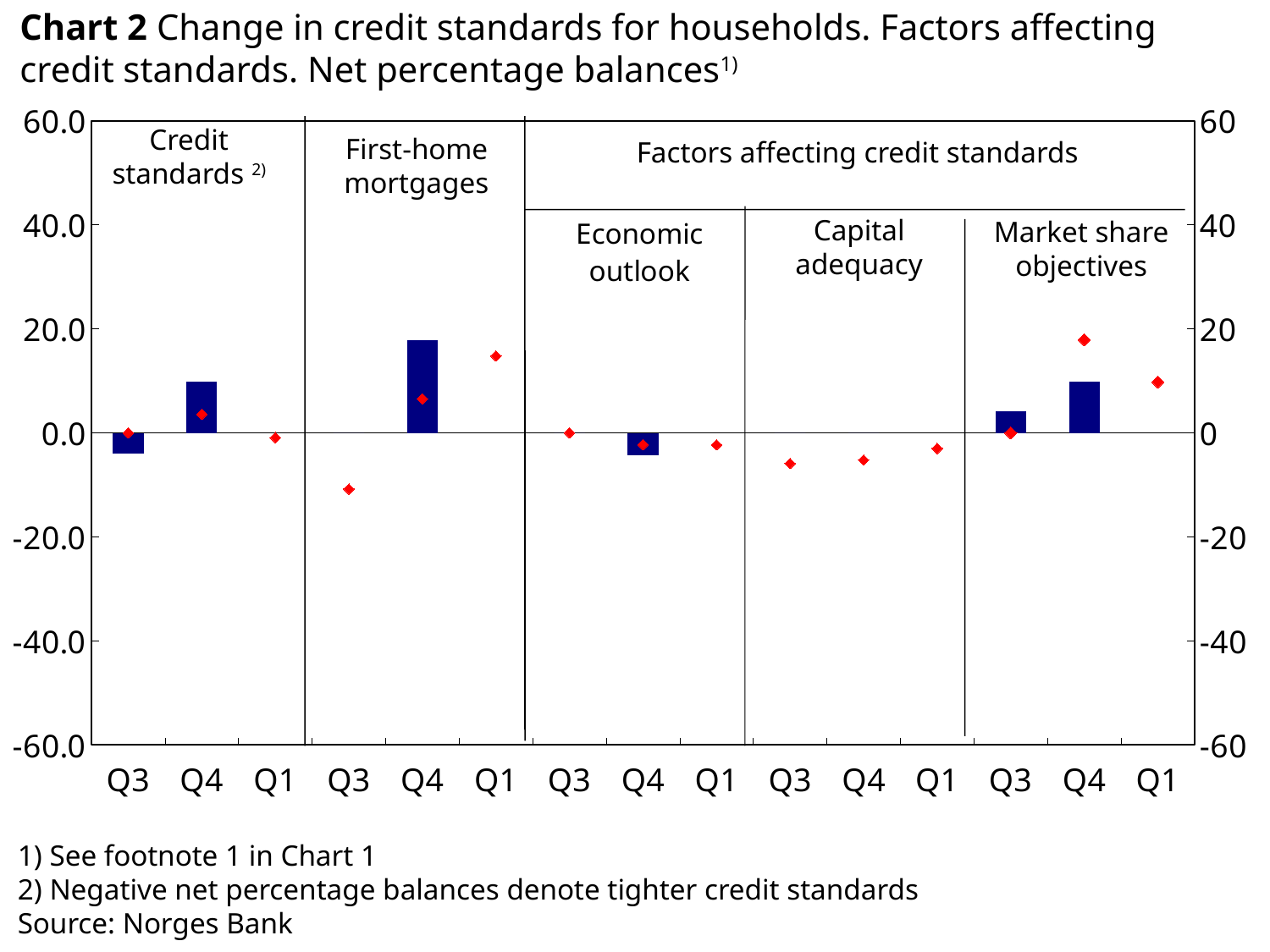
What kind of chart is Chart 2? combination chart (bars with diamond markers) How many quarter labels are shown along the x axis of Chart 2? 15 In the Market share objectives panel, which bar is taller, Q3 or Q4? Q4 In which panel of Chart 2 is the tallest bar found? First-home mortgages What source is cited for Chart 2? Norges Bank Is the Q4 bar in the First-home mortgages panel greater or less than 10? greater Is the Q3 diamond marker in the Capital adequacy panel greater or less than 0? less How many labelled panels (Credit standards, First-home mortgages, Economic outlook, Capital adequacy, Market share objectives) does Chart 2 have? 5 In the Credit standards panel, which bar is larger, Q3 or Q4? Q4 Is the Q3 diamond marker in the First-home mortgages panel greater or less than 0? less Do the diamond markers in the Capital adequacy panel rise or fall from Q3 to Q1? rise